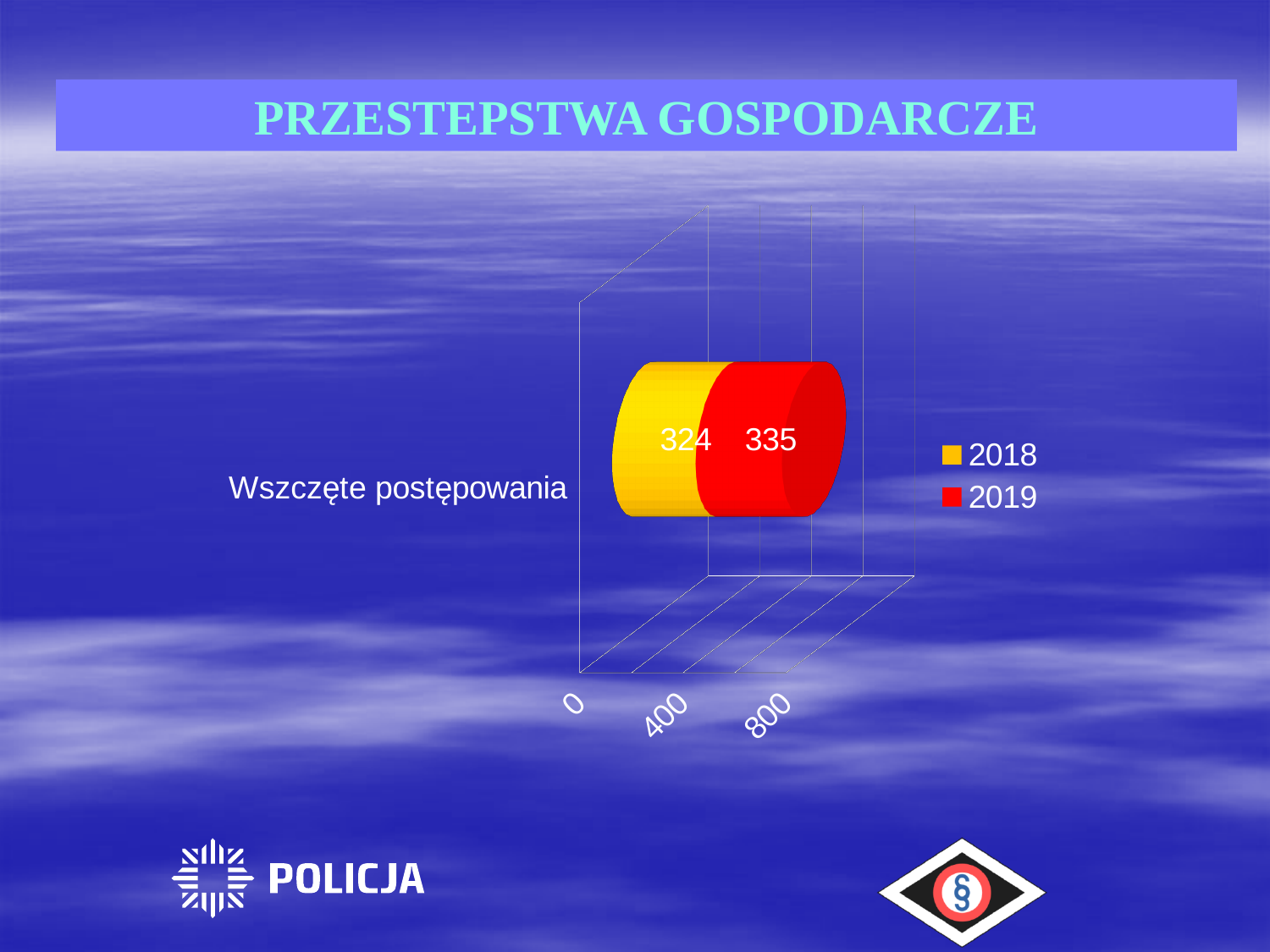
What is the difference between the 2019 and 2018 values for Wszczęte postępowania? 11 Which series has the higher value for Wszczęte postępowania, 2018 or 2019? 2019 Is the value for 2018 greater or less than 400? less What is the value for 2018 for Wszczęte postępowania? 324 What kind of chart is shown on the slide? bar chart How many series does the legend list? 2 Is the value for 2019 greater or less than 800? less What is the category label shown on the chart? Wszczęte postępowania Which colour represents the 2019 series in the legend? red What is the value for 2019 for Wszczęte postępowania? 335 How many categories are shown on the chart? 1